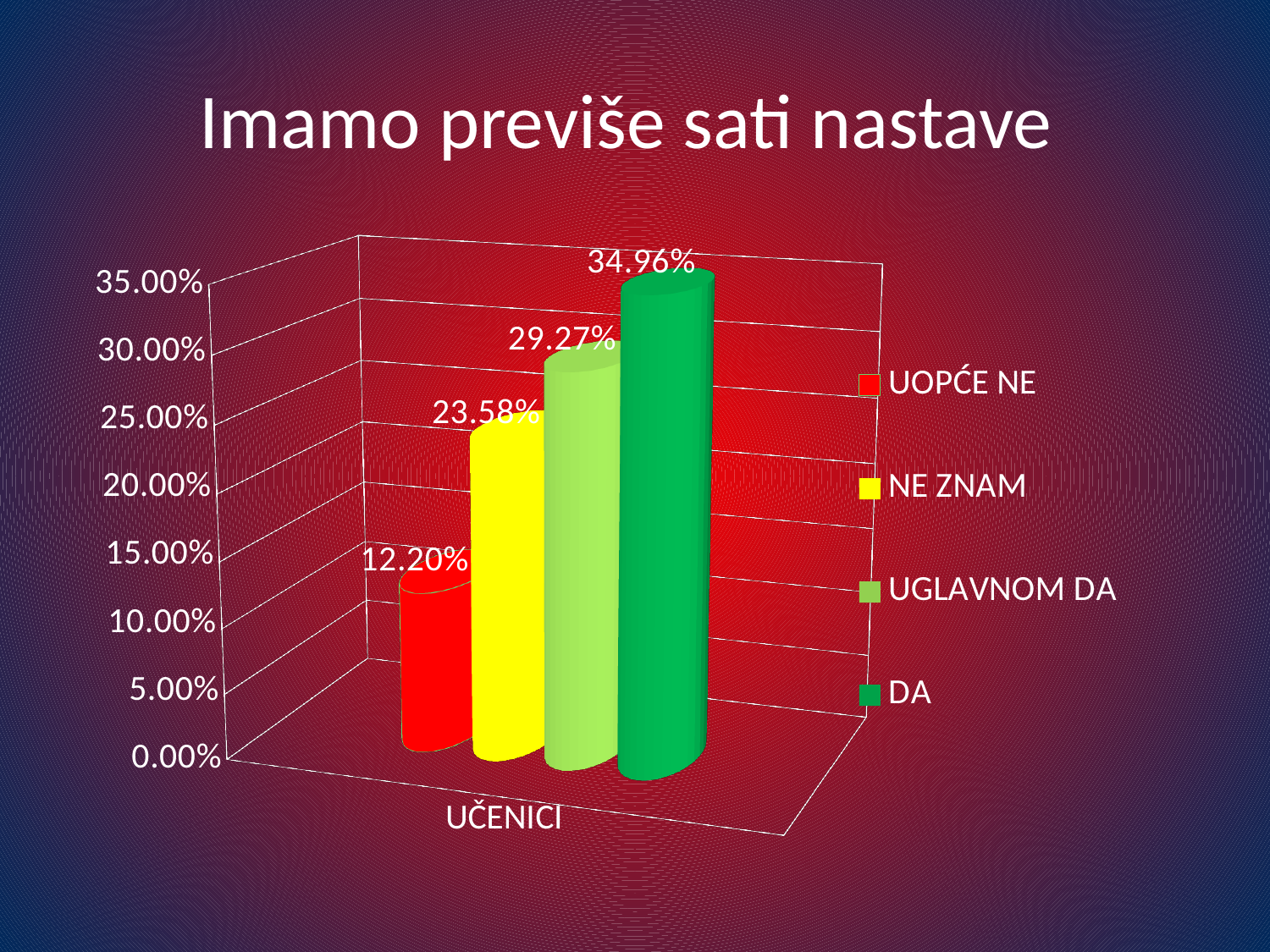
What is the value for DA? 34.96% What is the title of the chart? Imamo previše sati nastave Which series has the lowest value? UOPĆE NE What is the category label on the x axis? UČENICI What is the difference between the values for DA and UOPĆE NE? 22.76% What is the value for NE ZNAM? 23.58% What is the value for UGLAVNOM DA? 29.27% What kind of chart is shown? bar chart Which is larger, the value for NE ZNAM or the value for UGLAVNOM DA? UGLAVNOM DA Which series has the highest value? DA How many series does the legend list? 4 What is the value for UOPĆE NE? 12.20%